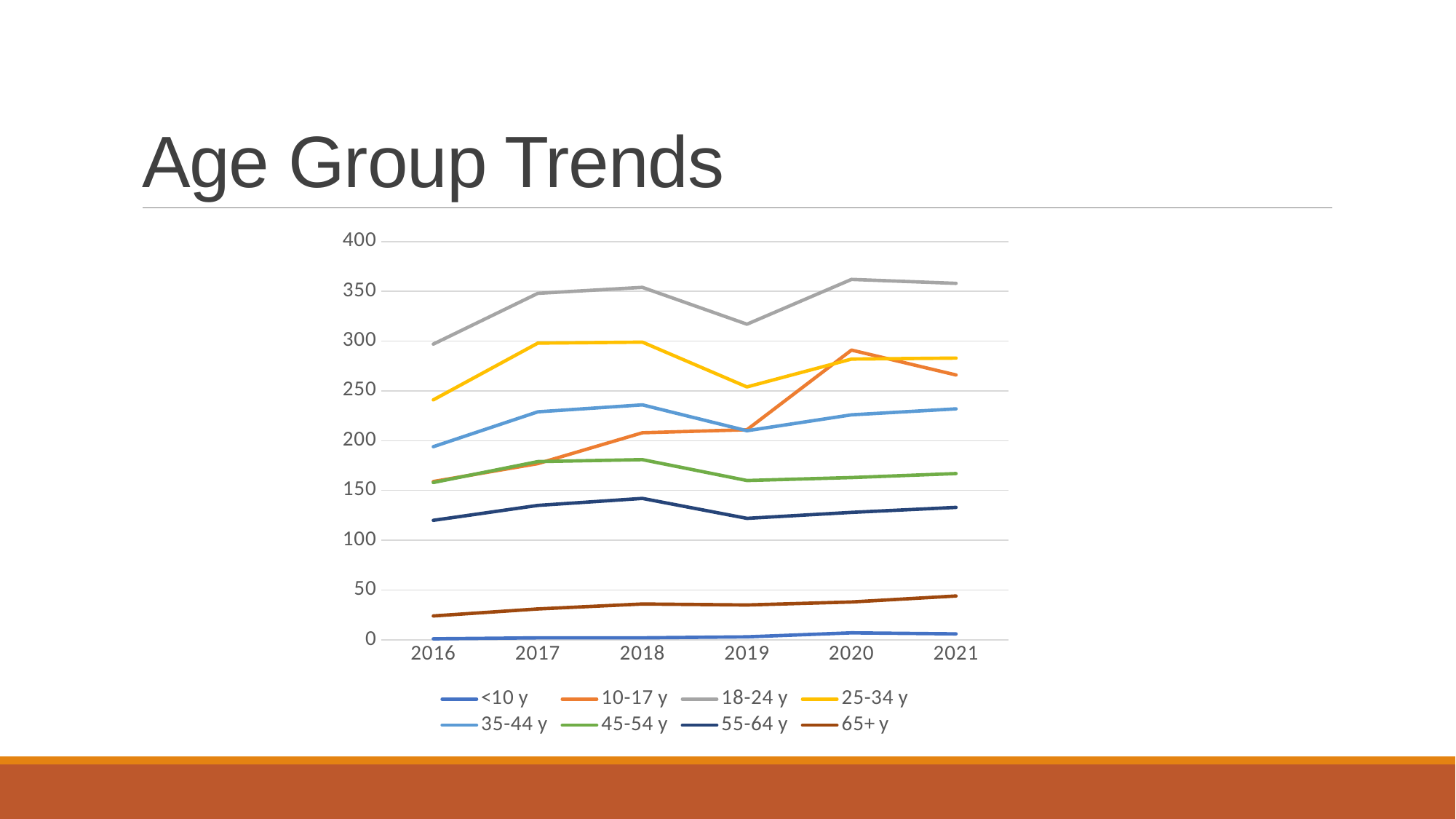
Which age group has the highest values across all years? 18-24 y Is the value for 18-24 y in 2020 greater or less than 350? greater In 2016, which is larger: the value for 35-44 y or the value for 45-54 y? 35-44 y How many years are shown along the x axis? 6 What kind of chart is shown on the slide? line chart What is the title of the slide? Age Group Trends Is the value for 25-34 y in 2016 greater or less than 250? less Is the value for 55-64 y in 2019 greater or less than 150? less Does the value for 65+ y rise or fall from 2016 to 2021? rise Which age group has the lowest values across all years? <10 y How many series does the legend list? 8